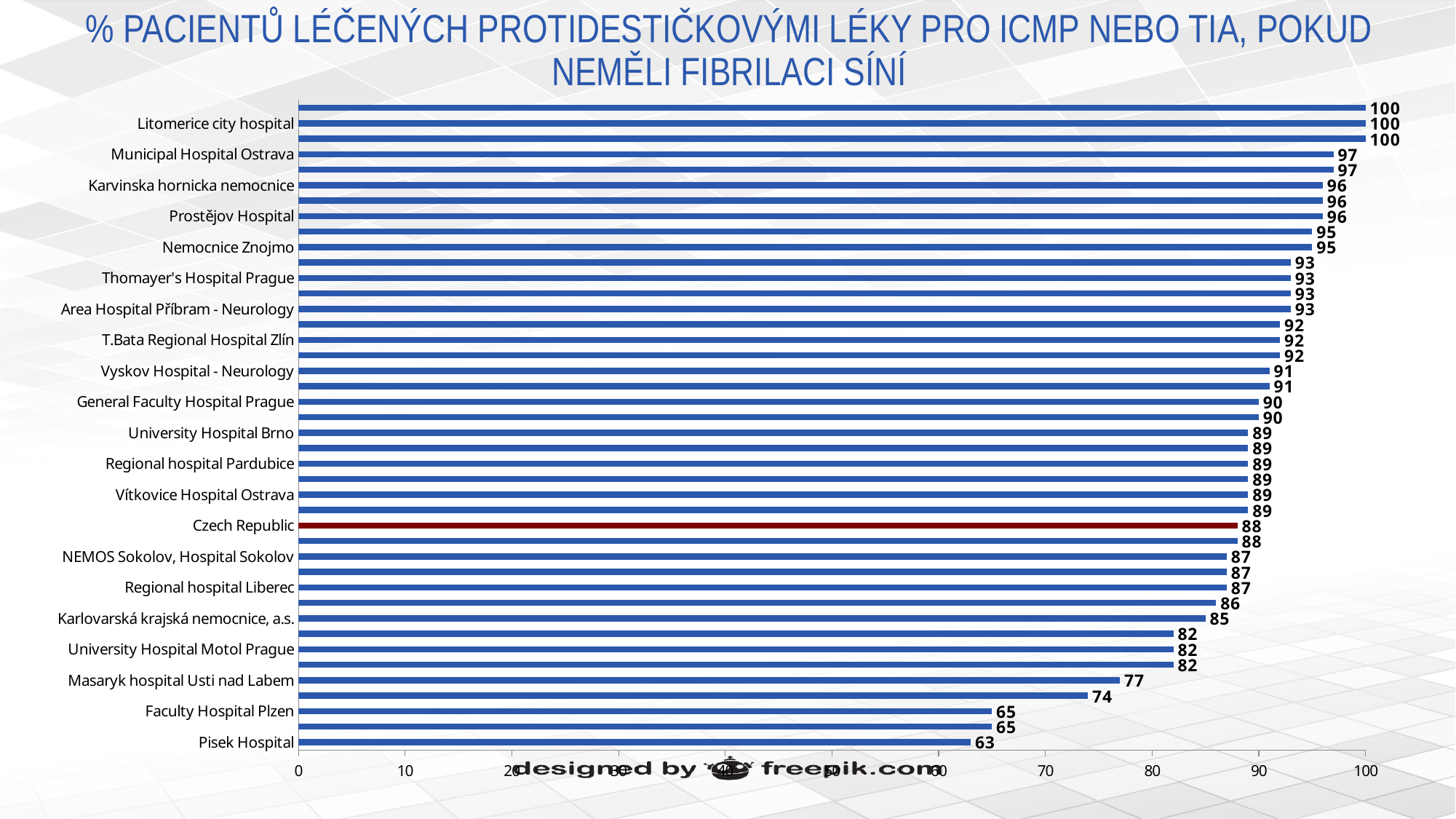
Which category's bar is coloured red instead of blue? Czech Republic Which labelled hospital has the lowest value? Pisek Hospital What is the value for University Hospital Motol Prague? 82 Which has a larger value, Masaryk hospital Usti nad Labem or Faculty Hospital Plzen? Masaryk hospital Usti nad Labem What is the value for Czech Republic? 88 What is the value for Nemocnice Znojmo? 95 What is the difference between the values for Czech Republic and Pisek Hospital? 25 What is the value for Masaryk hospital Usti nad Labem? 77 What is the value for Pisek Hospital? 63 What kind of chart is shown on the slide? bar chart What is the value for Litomerice city hospital? 100 Is the value for Pisek Hospital greater or less than 70? less